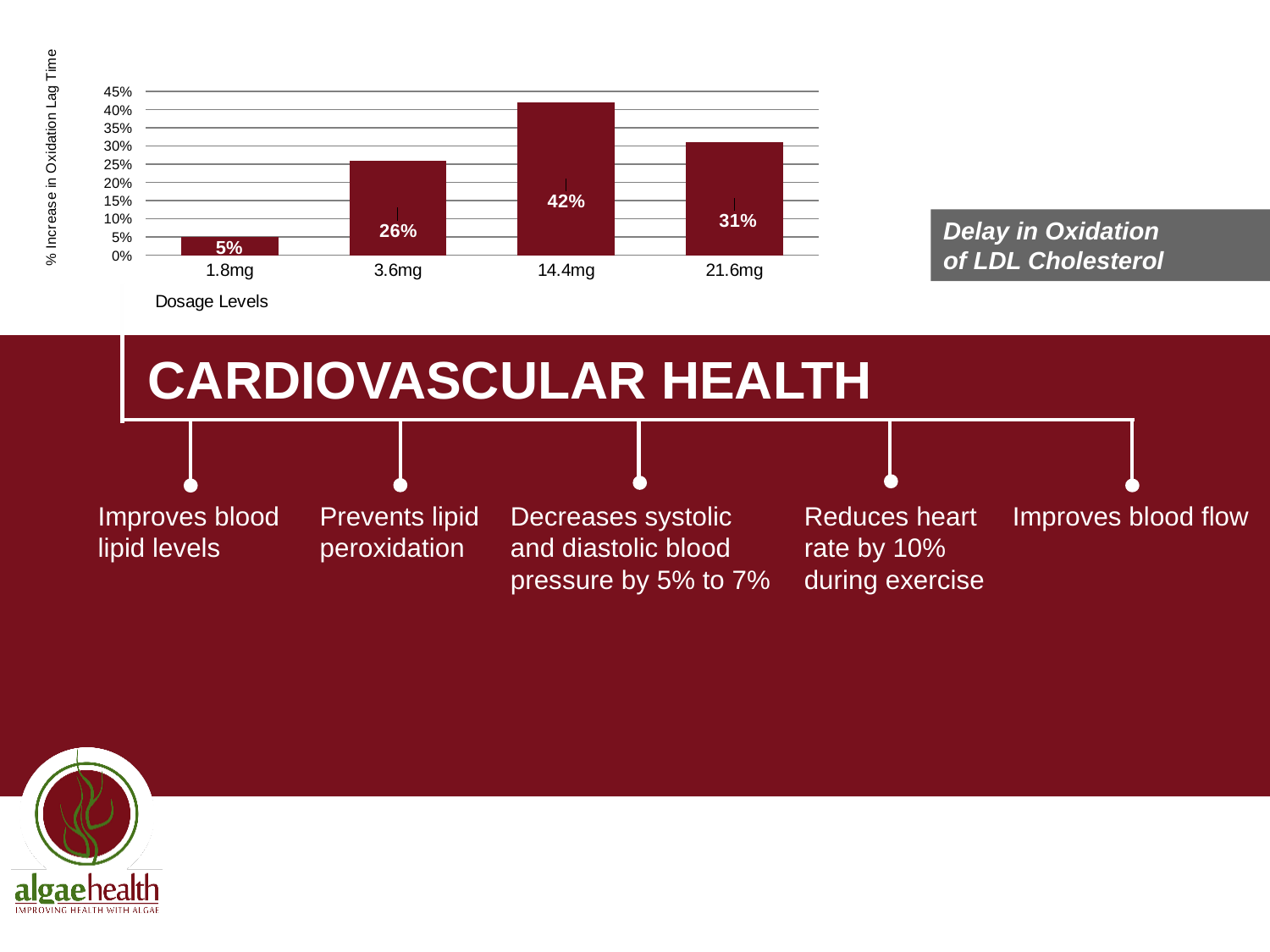
What kind of chart is used to show the % increase in oxidation lag time? Bar chart Which dosage level has a larger % increase in oxidation lag time, 3.6mg or 21.6mg? 21.6mg Which dosage level shows the lowest % increase in oxidation lag time? 1.8mg How many dosage levels are shown on the chart? 4 Which dosage level shows the highest % increase in oxidation lag time? 14.4mg What is the difference in % increase in oxidation lag time between the 14.4mg and 21.6mg dosage levels? 11% Is the value for the 14.4mg dosage level greater or less than 40%? greater What is the % increase in oxidation lag time at the 14.4mg dosage level? 42% What is the % increase in oxidation lag time at the 1.8mg dosage level? 5% What is the % increase in oxidation lag time at the 3.6mg dosage level? 26% What is the % increase in oxidation lag time at the 21.6mg dosage level? 31% What is the label of the x axis on the chart? Dosage Levels